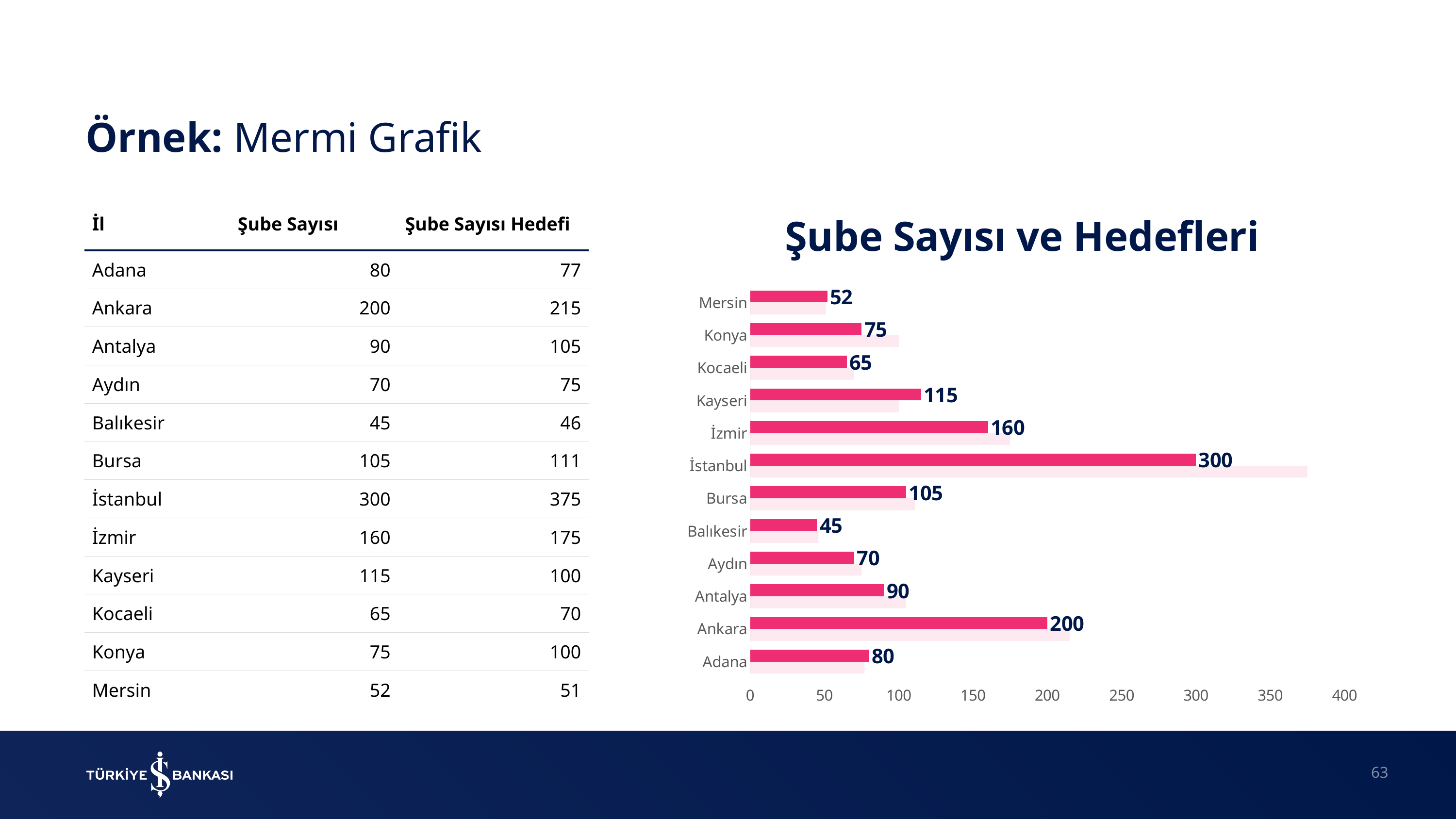
Which has a larger labelled value in the chart, Bursa or Antalya? Bursa What is the difference between the labelled values for Ankara and İzmir? 40 How many cities are shown in the chart? 12 What is the title of the chart? Şube Sayısı ve Hedefleri Is the light target bar for İstanbul greater or less than 350? greater What is the value shown for Kayseri in the chart? 115 What is the value shown for Mersin in the chart? 52 Is the light target bar for Ankara greater or less than 200? greater What type of chart is shown on the slide? Bar chart Which city has the highest labelled value in the chart? İstanbul What is the value shown for İstanbul in the chart? 300 Which city has the lowest labelled value in the chart? Balıkesir